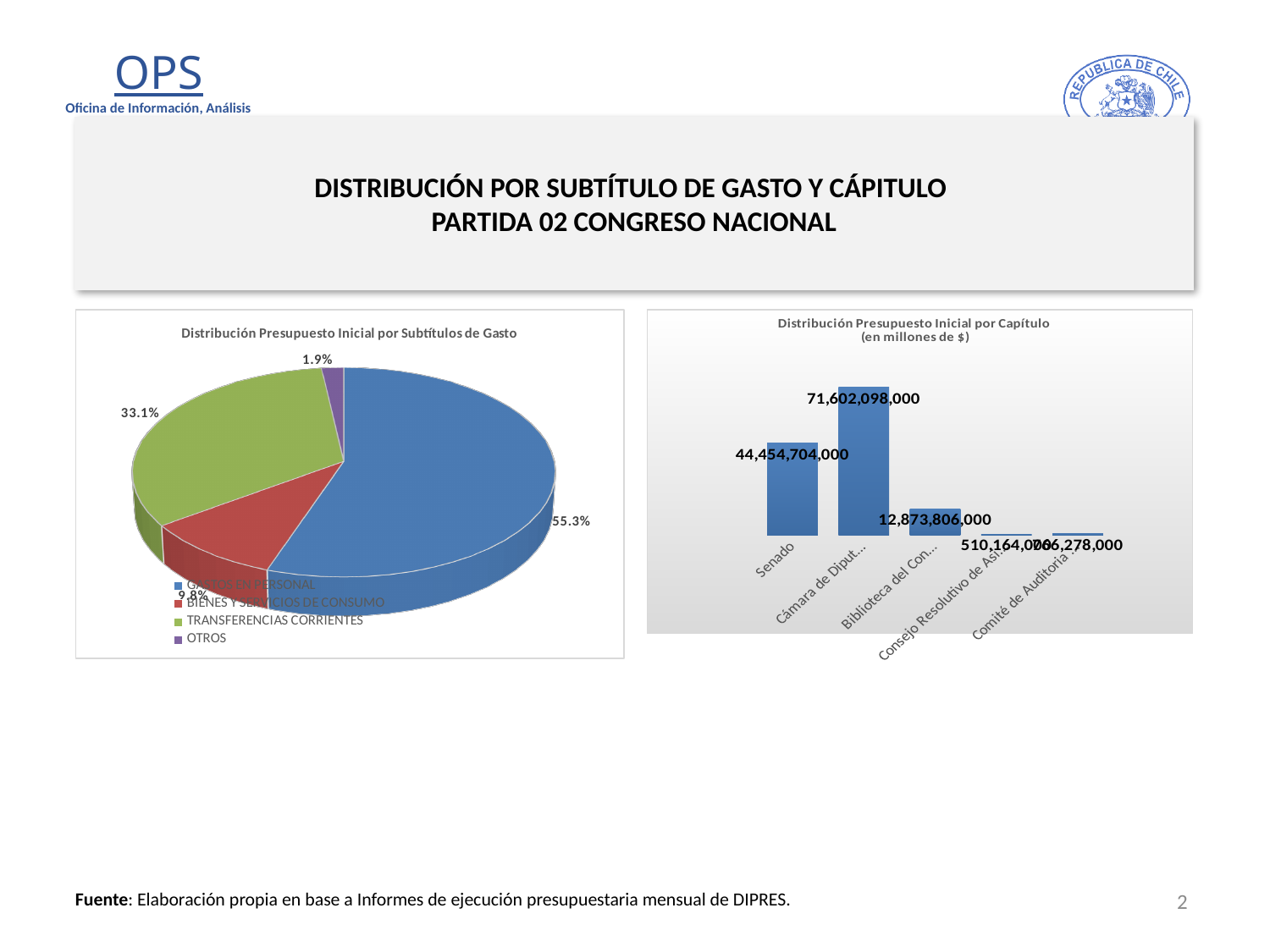
In the pie chart on the left, what percentage is shown for OTROS? 1.9% What kind of chart is 'Distribución Presupuesto Inicial por Capítulo'? bar chart How many entries does the legend of the pie chart on the left list? 4 In the pie chart on the left, which category has the smallest slice? OTROS In the bar chart on the right, what is the difference between the values for Senado and Biblioteca del Con...? 31,580,898,000 In the bar chart 'Distribución Presupuesto Inicial por Capítulo', what is the value for Senado? 44,454,704,000 In the bar chart on the right, how many categories are shown? 5 In the pie chart 'Distribución Presupuesto Inicial por Subtítulos de Gasto', what share does GASTOS EN PERSONAL have? 55.3% In the bar chart on the right, which category has the highest value? Cámara de Diput... In the pie chart on the left, what percentage is shown for TRANSFERENCIAS CORRIENTES? 33.1% In the pie chart on the left, how many percentage points larger is GASTOS EN PERSONAL than TRANSFERENCIAS CORRIENTES? 22.2% In the pie chart on the left, which category has the largest slice? GASTOS EN PERSONAL